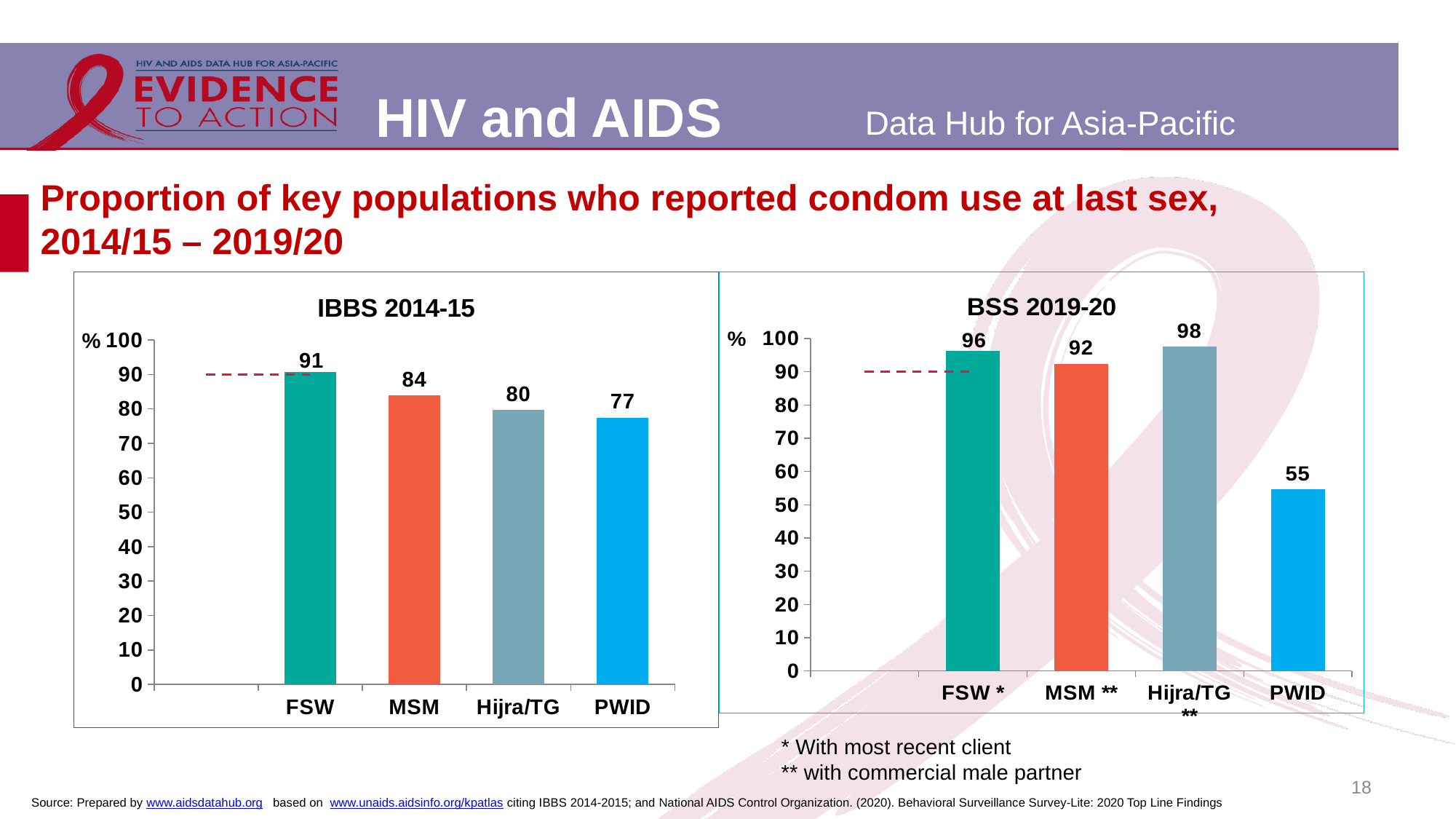
In the BSS 2019-20 chart, what is the difference between the values for Hijra/TG ** and PWID? 43 In the IBBS 2014-15 chart, which category has the lowest value? PWID What is the title of the chart on the left side of the slide? IBBS 2014-15 In the BSS 2019-20 chart, which category has the highest value? Hijra/TG ** In the IBBS 2014-15 chart, is the value for Hijra/TG greater or less than 90? less In the BSS 2019-20 chart, what is the value for PWID? 55 In the IBBS 2014-15 chart, what is the difference between the values for FSW and MSM? 7 In the IBBS 2014-15 chart, do the values rise or fall from FSW to PWID? fall In the IBBS 2014-15 chart, what is the value for FSW? 91 What kind of chart is the BSS 2019-20 chart? bar chart How many categories are shown in the IBBS 2014-15 chart? 4 In the BSS 2019-20 chart, which is larger, the value for FSW * or the value for MSM **? FSW *